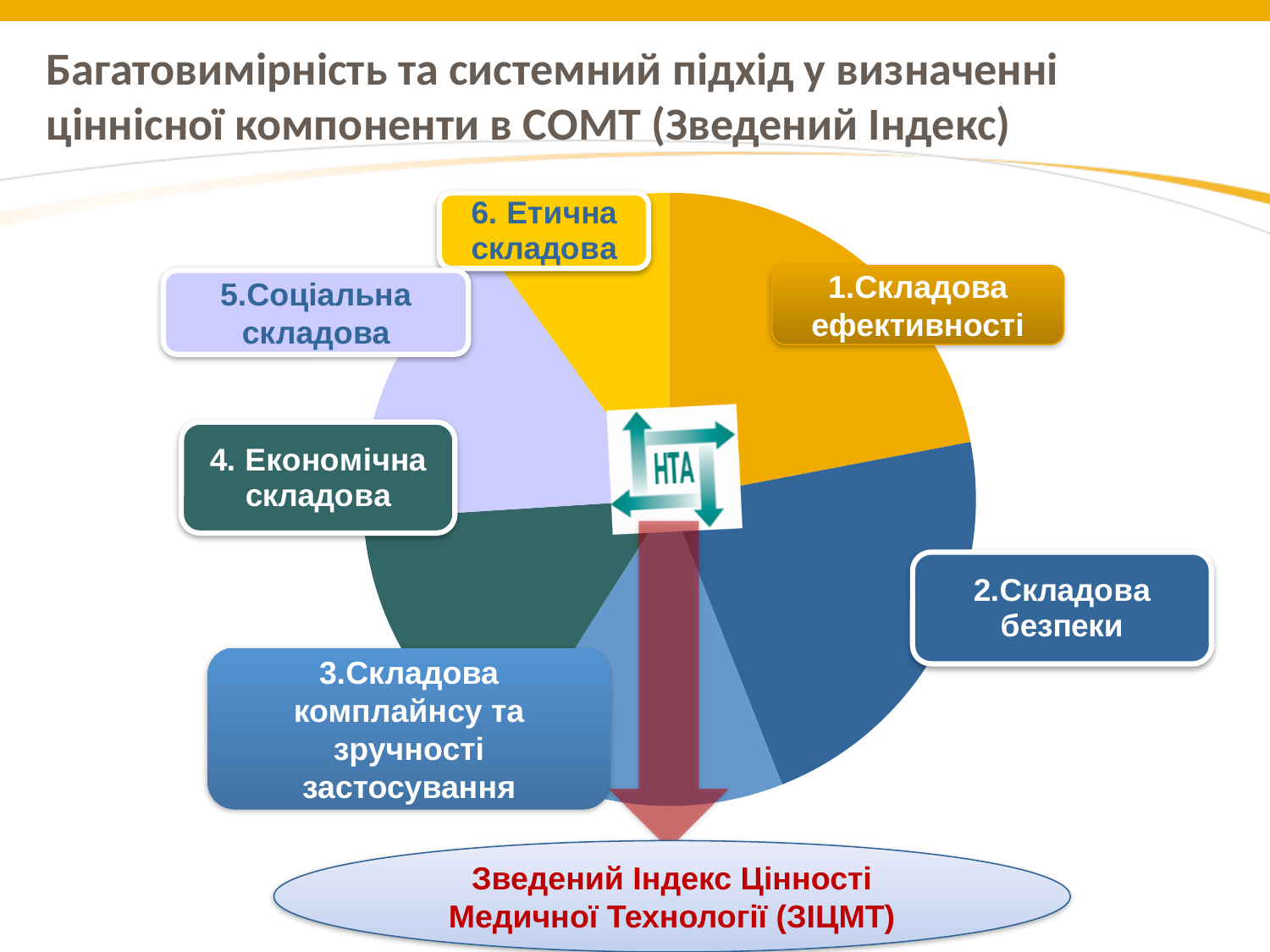
Which slice is larger: "1.Складова ефективності" or "6. Етична складова"? 1.Складова ефективності Which slice is larger: "5.Соціальна складова" or "6. Етична складова"? 5.Соціальна складова What kind of chart is shown on the slide? pie chart What is the label of the yellow slice at the top of the pie chart? 6. Етична складова How many slices does the pie chart have? 6 Which slice is larger: "4. Економічна складова" or "6. Етична складова"? 4. Економічна складова What does the arrow below the pie chart point to? Зведений Індекс Цінності Медичної Технології (ЗІЦМТ)